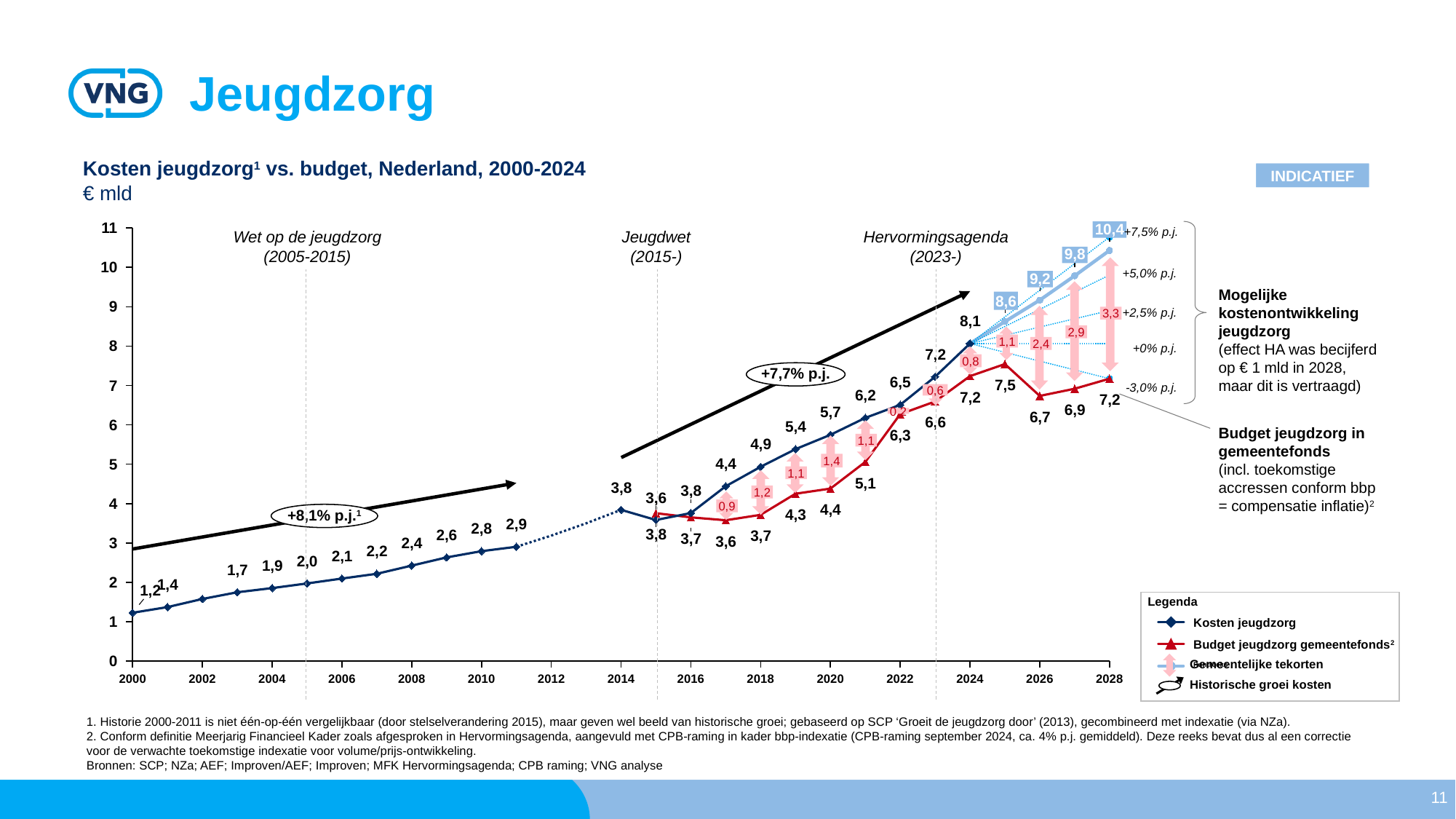
What is the value of Budget jeugdzorg gemeentefonds in 2028? 7,2 In 2020, which is larger: Kosten jeugdzorg or Budget jeugdzorg gemeentefonds? Kosten jeugdzorg What is the value of Kosten jeugdzorg in 2000? 1,2 What historical growth rate is labelled for the period 2000-2011? +8,1% p.j. Do the Kosten jeugdzorg values rise or fall between 2000 and 2011? Rise What is the highest projected value of Kosten jeugdzorg shown, in 2028? 10,4 What is the lowest value of Budget jeugdzorg gemeentefonds, reached in 2017? 3,6 What kind of chart is shown on the slide? Line chart What is the labelled gemeentelijk tekort (gap between kosten and budget) in 2026? 2,4 What is the difference between Kosten jeugdzorg in 2024 and in 2023? 0,9 What is the value of Kosten jeugdzorg in 2024? 8,1 How many entries does the legend list? 4